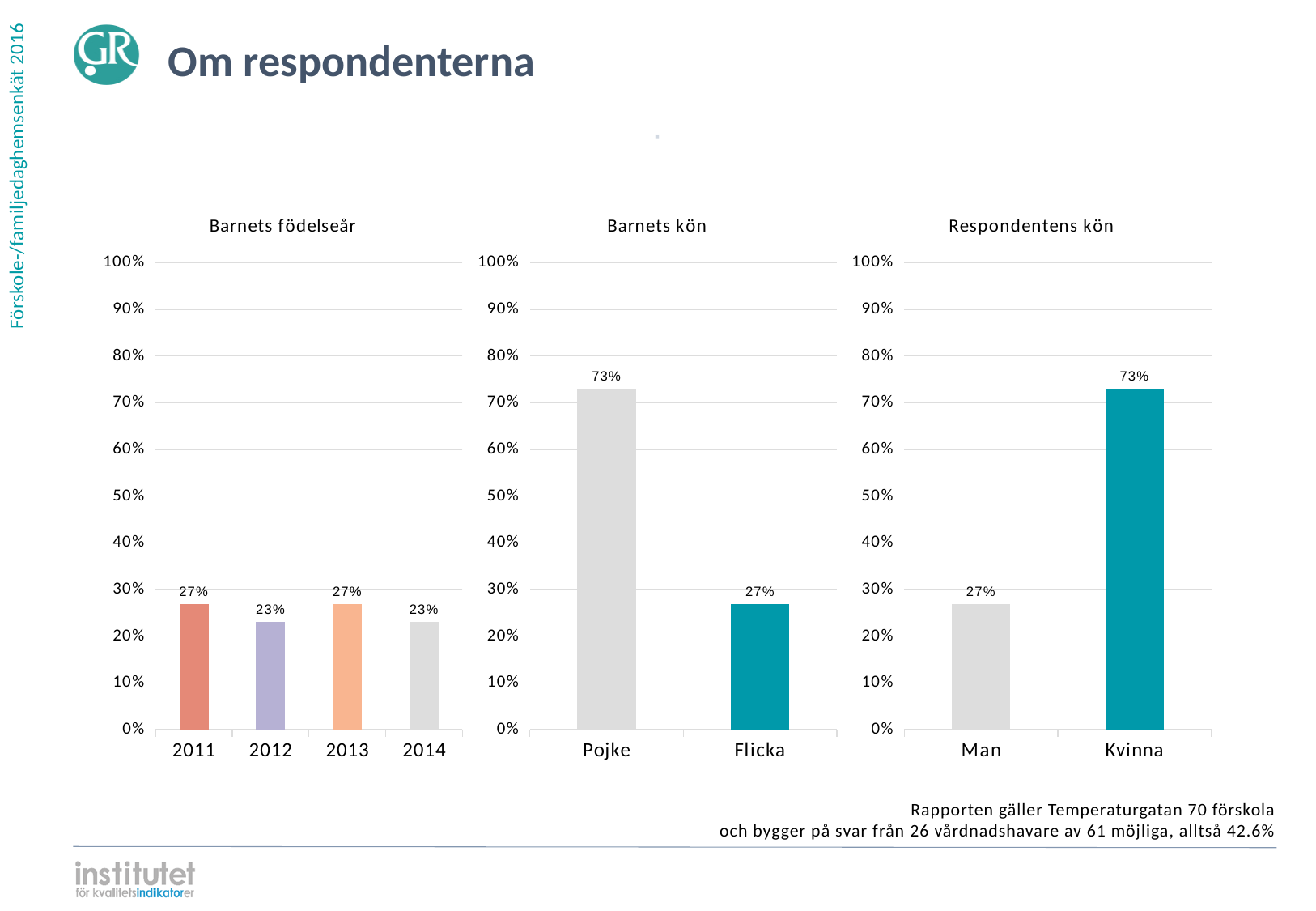
In the 'Barnets födelseår' chart, how many categories are shown on the x axis? 4 In the 'Barnets kön' chart, what is the value for Pojke? 73% What is the title of the chart on the right of the slide? Respondentens kön In the 'Respondentens kön' chart, which category has the highest value? Kvinna In the 'Barnets födelseår' chart, what is the difference between the values for 2011 and 2014? 4% What kind of chart is the 'Barnets kön' chart? Bar chart In the 'Barnets födelseår' chart, what is the value for 2012? 23% In the 'Respondentens kön' chart, what is the value for Man? 27% In the 'Barnets kön' chart, which category has the lowest value? Flicka In the 'Barnets kön' chart, what is the difference between the values for Pojke and Flicka? 46% In the 'Barnets födelseår' chart, what is the value for 2013? 27% In the 'Respondentens kön' chart, is the value for Kvinna greater or less than 50%? greater